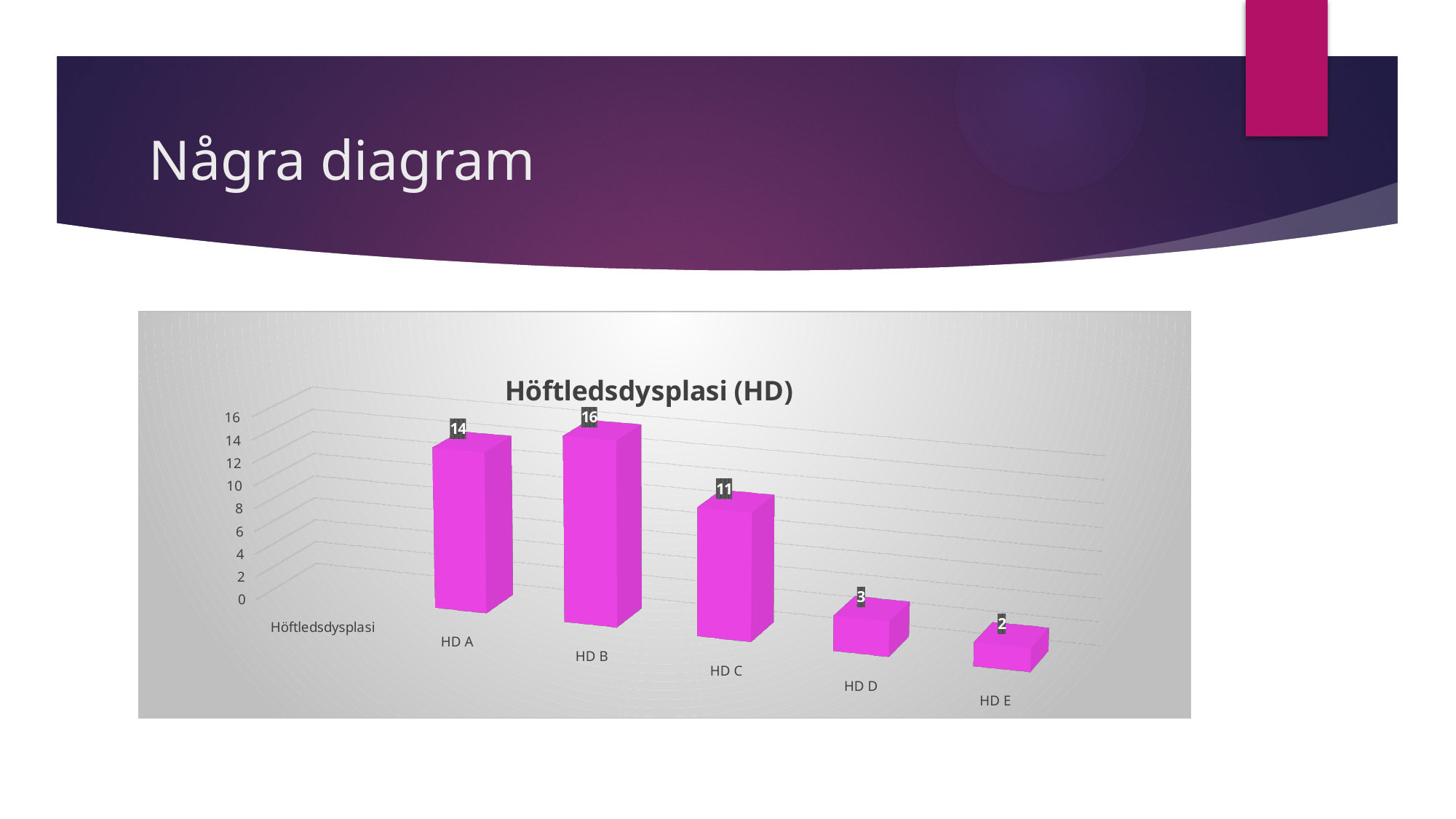
What is the difference between the values for HD A and HD D? 11 Which category has the lowest value? HD E What kind of chart is shown on the slide? bar chart What is the difference between the values for HD B and HD C? 5 Do the values rise or fall from HD B to HD E? fall What is the title of the chart? Höftledsdysplasi (HD) What is the value for HD E? 2 Which category has the highest value? HD B What is the value for HD C? 11 What is the value for HD A? 14 Which is larger, the value for HD A or the value for HD C? HD A